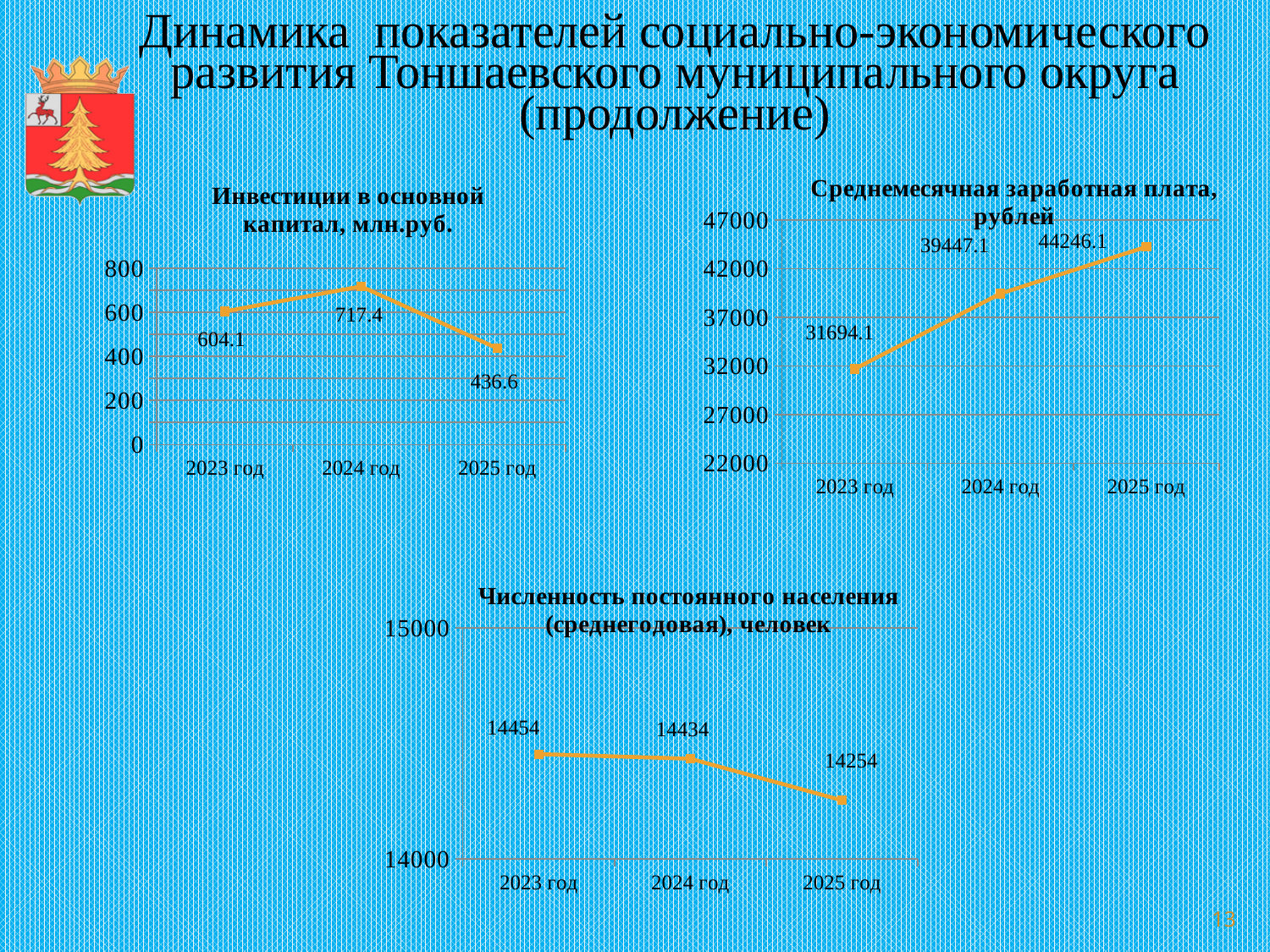
On the chart 'Инвестиции в основной капитал, млн.руб.', what is the value for 2024 год? 717.4 On the chart 'Среднемесячная заработная плата, рублей', which year has the highest value? 2025 год How many years are plotted on the chart 'Инвестиции в основной капитал, млн.руб.'? 3 On the chart 'Среднемесячная заработная плата, рублей', what is the difference between the 2025 год and 2023 год values? 12552 On the chart 'Численность постоянного населения (среднегодовая), человек', which is larger, the value for 2023 год or 2024 год? 2023 год On the chart 'Инвестиции в основной капитал, млн.руб.', which year has the lowest value? 2025 год What kind of chart is 'Численность постоянного населения (среднегодовая), человек'? line chart On the chart 'Численность постоянного населения (среднегодовая), человек', what is the value for 2025 год? 14254 On the chart 'Среднемесячная заработная плата, рублей', what is the value for 2023 год? 31694.1 On the chart 'Инвестиции в основной капитал, млн.руб.', what is the difference between the 2024 год and 2025 год values? 280.8 On the chart 'Численность постоянного населения (среднегодовая), человек', what is the difference between the 2023 год and 2025 год values? 200 On the chart 'Среднемесячная заработная плата, рублей', do the values rise or fall from 2023 год to 2025 год? rise